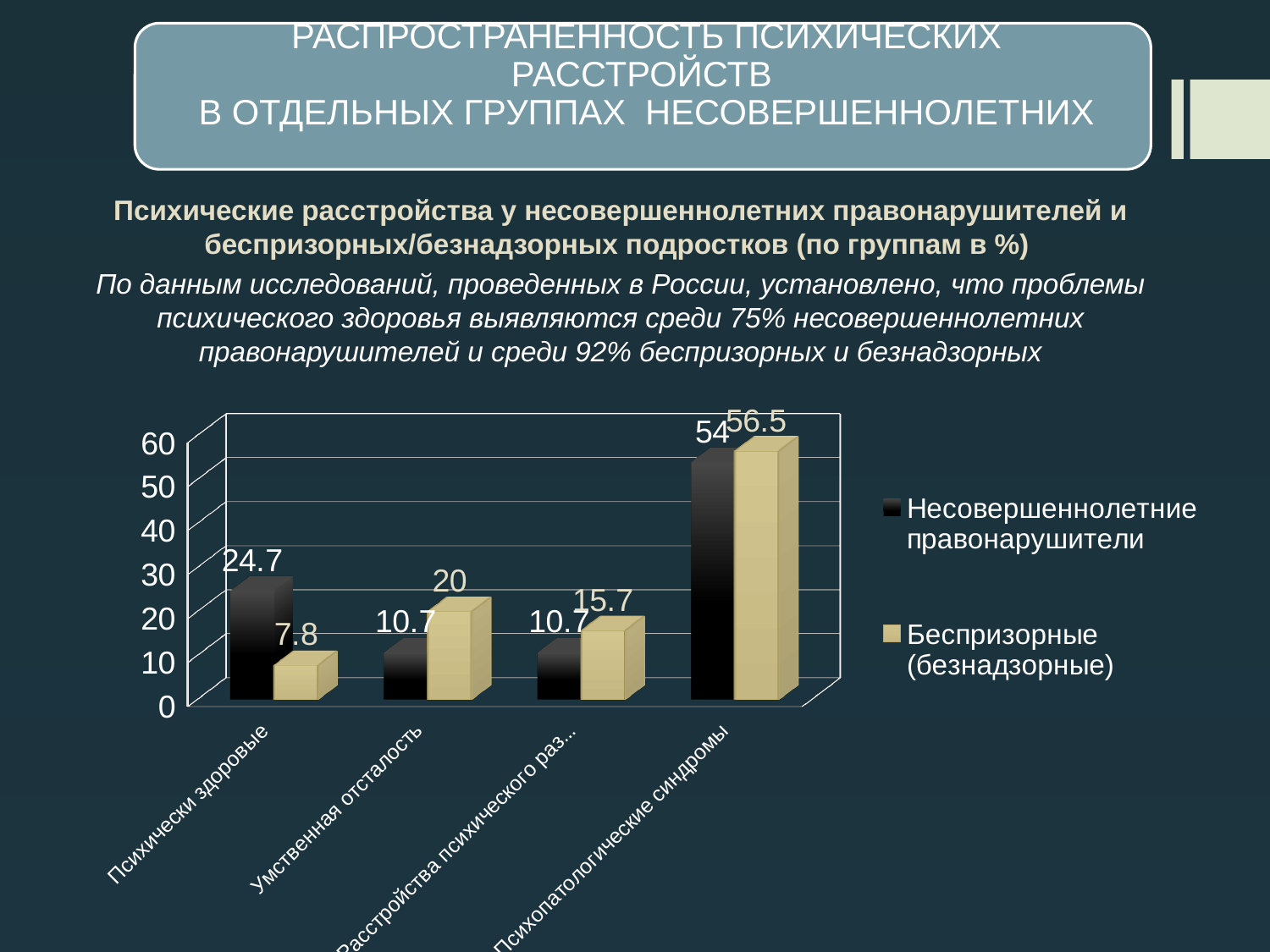
What is the value for Психически здоровые in the Беспризорные (безнадзорные) series? 7.8 How many series does the chart legend list? 2 What is the value for Психопатологические синдромы in the Несовершеннолетние правонарушители series? 54 Which category has the highest value in the Беспризорные (безнадзорные) series? Психопатологические синдромы For Умственная отсталость, which series has the larger value: Несовершеннолетние правонарушители or Беспризорные (безнадзорные)? Беспризорные (безнадзорные) Is the value for Психически здоровые in the Несовершеннолетние правонарушители series greater or less than 20? greater What is the difference between the Беспризорные (безнадзорные) and Несовершеннолетние правонарушители values for Психопатологические синдромы? 2.5 Which category has the lowest value in the Беспризорные (безнадзорные) series? Психически здоровые How many categories are shown on the x axis of the chart? 4 What is the value for Психически здоровые in the Несовершеннолетние правонарушители series? 24.7 What type of chart is shown on the slide? Bar chart What is the value for Умственная отсталость in the Беспризорные (безнадзорные) series? 20